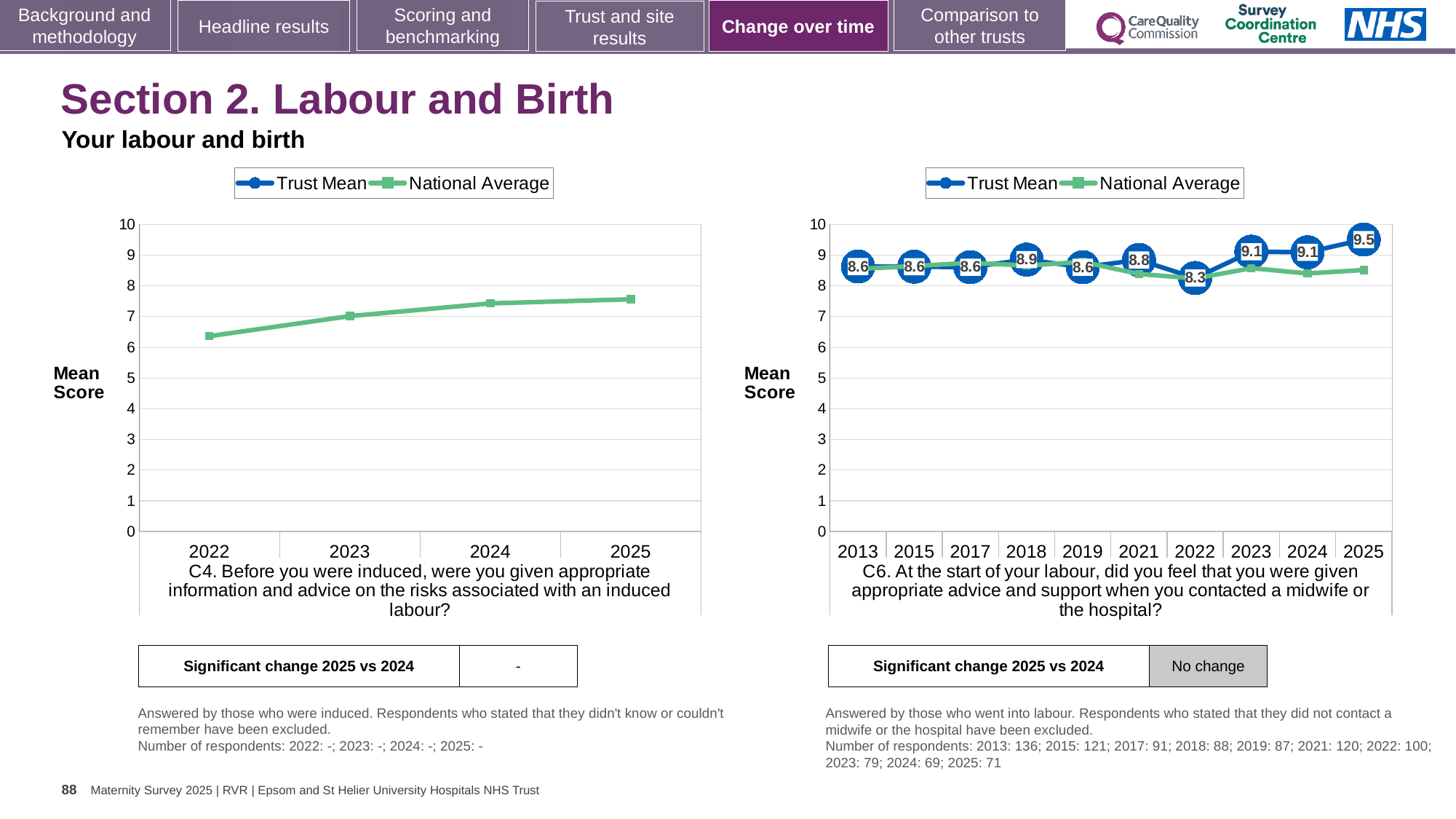
On the left chart (C4), does the National Average rise or fall from 2022 to 2025? rise How many series does the legend of the left chart (C4) list? 2 On the right chart (C6), in which year is the Trust Mean lowest? 2022 On the right chart (C6), in which year is the Trust Mean highest? 2025 On the right chart (C6), what is the Trust Mean score for 2022? 8.3 On the right chart (C6), what is the Trust Mean score for 2018? 8.9 On the left chart (C4), is the National Average value for 2022 greater or less than 7? less On the left chart (C4), how many years are shown on the x axis? 4 On the right chart (C6), what is the Trust Mean score for 2025? 9.5 On the right chart (C6), how many years are shown on the x axis? 10 On the right chart (C6), which year has the higher Trust Mean, 2018 or 2022? 2018 On the right chart (C6), what is the difference between the Trust Mean in 2025 and in 2022? 1.2